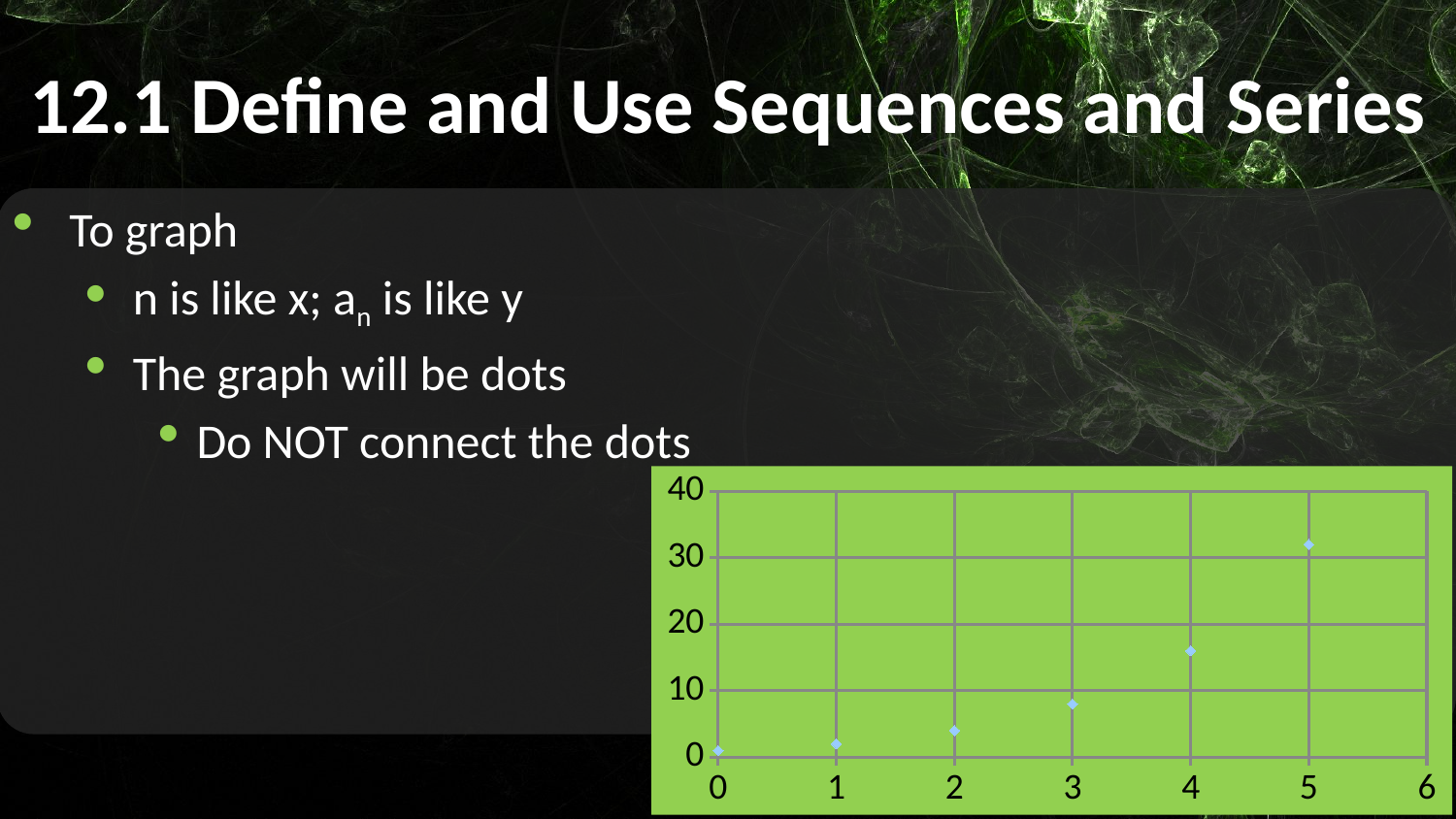
What kind of chart is shown on the slide? scatter plot Is the value of the point at x = 4 greater or less than 20? less What is the highest value shown on the chart's x axis? 6 Do the plotted values rise or fall as n increases along the x axis? rise What is the highest value shown on the chart's y axis? 40 Which point has the larger value, the one at x = 4 or the one at x = 5? x = 5 At which x value is the plotted point highest? 5 Is the value of the point at x = 3 greater or less than 10? less Is the value of the point at x = 4 greater or less than 10? greater Which point has the larger value, the one at x = 2 or the one at x = 4? x = 4 How many data points are plotted on the chart? 6